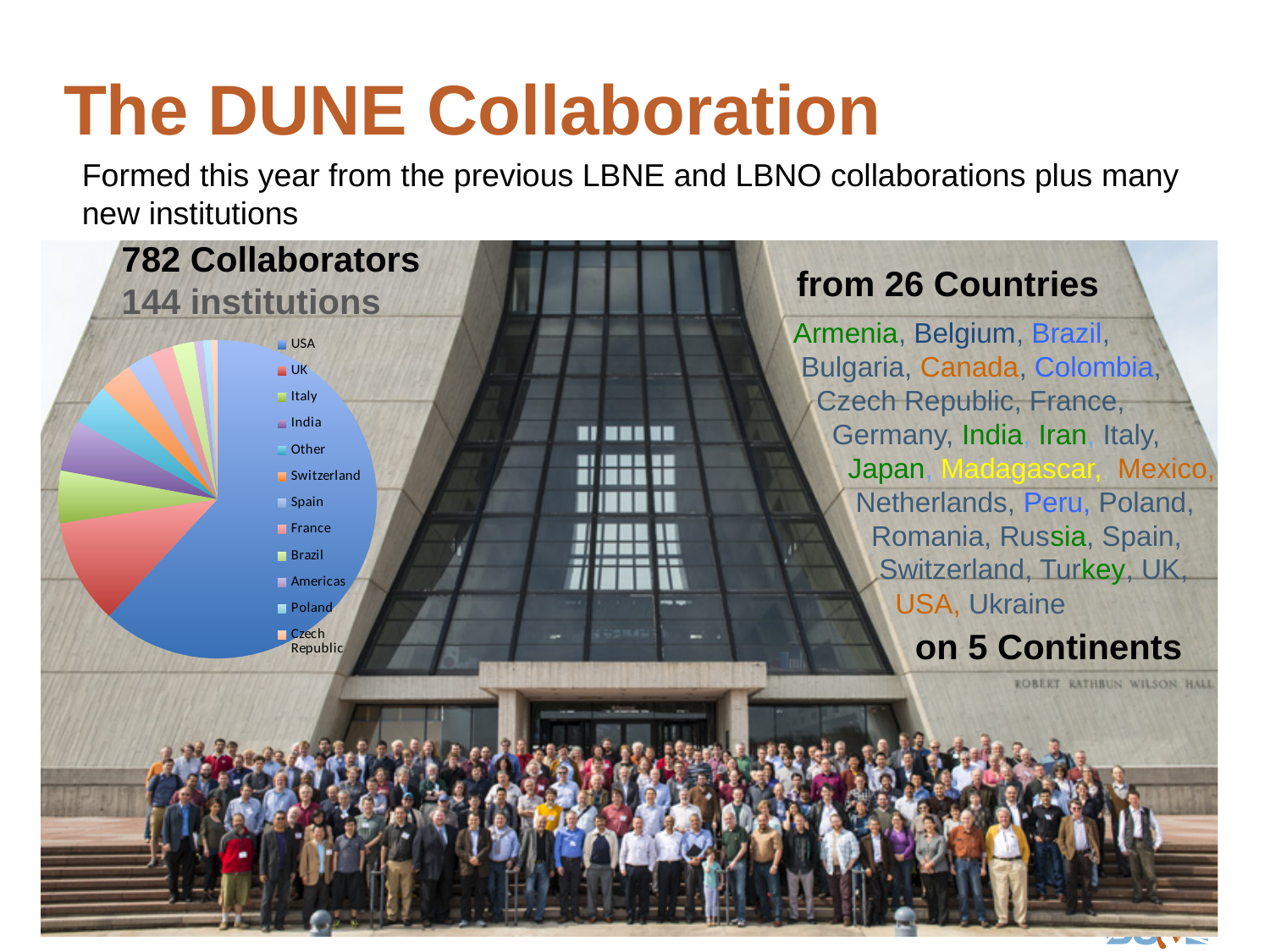
Which slice is larger in the pie chart, UK or Czech Republic? UK Which slice is larger in the pie chart, USA or UK? USA Which category is listed first in the pie chart's legend? USA Which slice is larger in the pie chart, UK or Italy? UK How many categories does the pie chart's legend list? 12 Which category is listed last in the pie chart's legend? Czech Republic What kind of chart is shown on the slide? pie chart Which category has the largest slice in the pie chart? USA